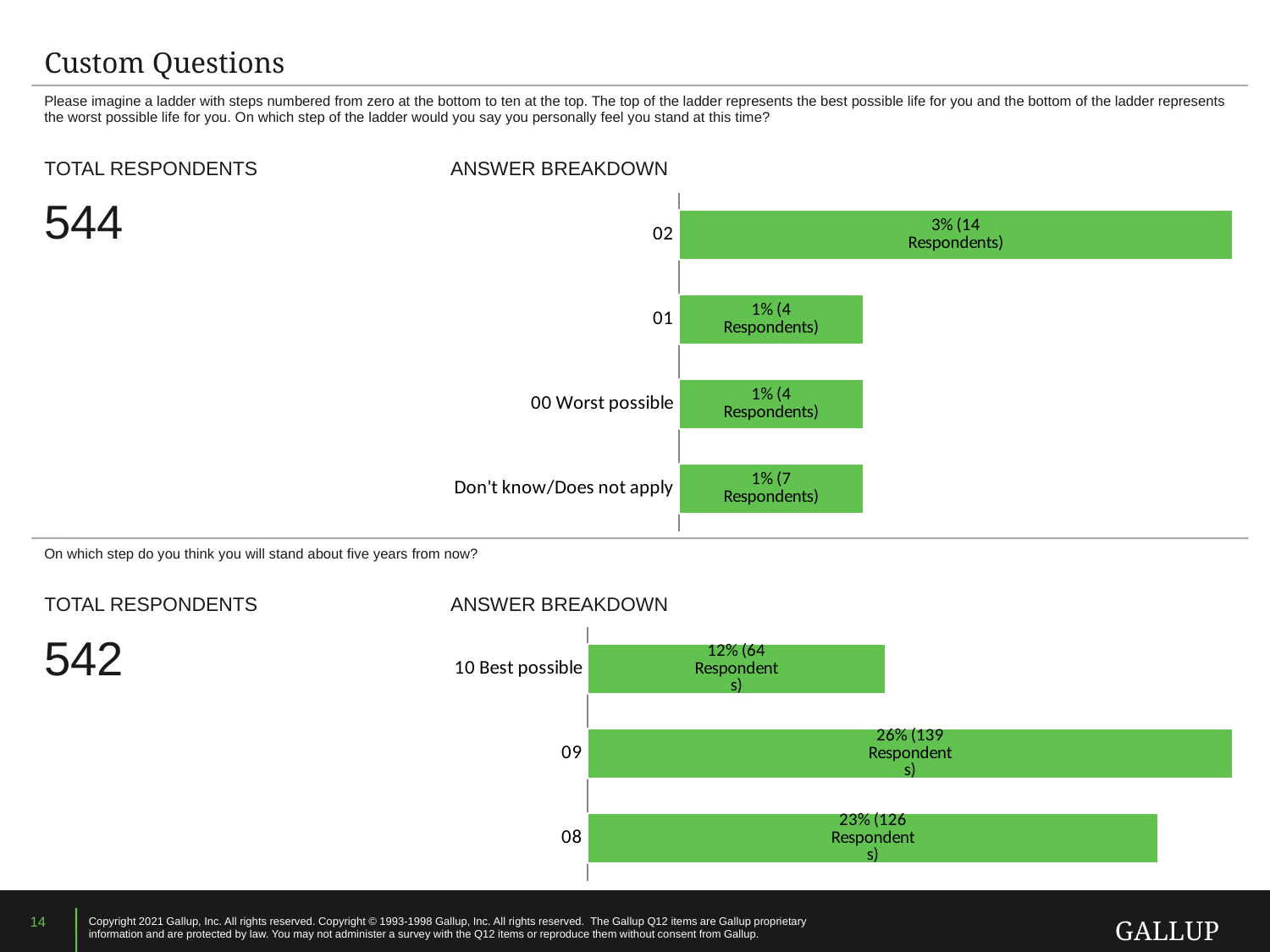
In the top chart, how many respondents chose 'Don't know/Does not apply'? 7 In the bottom chart, which has more respondents, step 09 or step 08? 09 In the bottom chart, what percentage of respondents chose step 09? 26% In the top chart, how many more respondents chose 02 than 01? 10 In the top chart, what percentage of respondents chose step 02? 3% In the top chart, how many categories are shown? 4 In the top chart, which category has the highest percentage? 02 In the bottom chart, what is the difference in respondents between step 09 and step 08? 13 In the bottom chart, how many respondents chose '10 Best possible'? 64 In the bottom chart, which category has the lowest percentage? 10 Best possible What type of chart is used in the bottom chart? Bar chart What is the total number of respondents shown for the bottom chart's question? 542